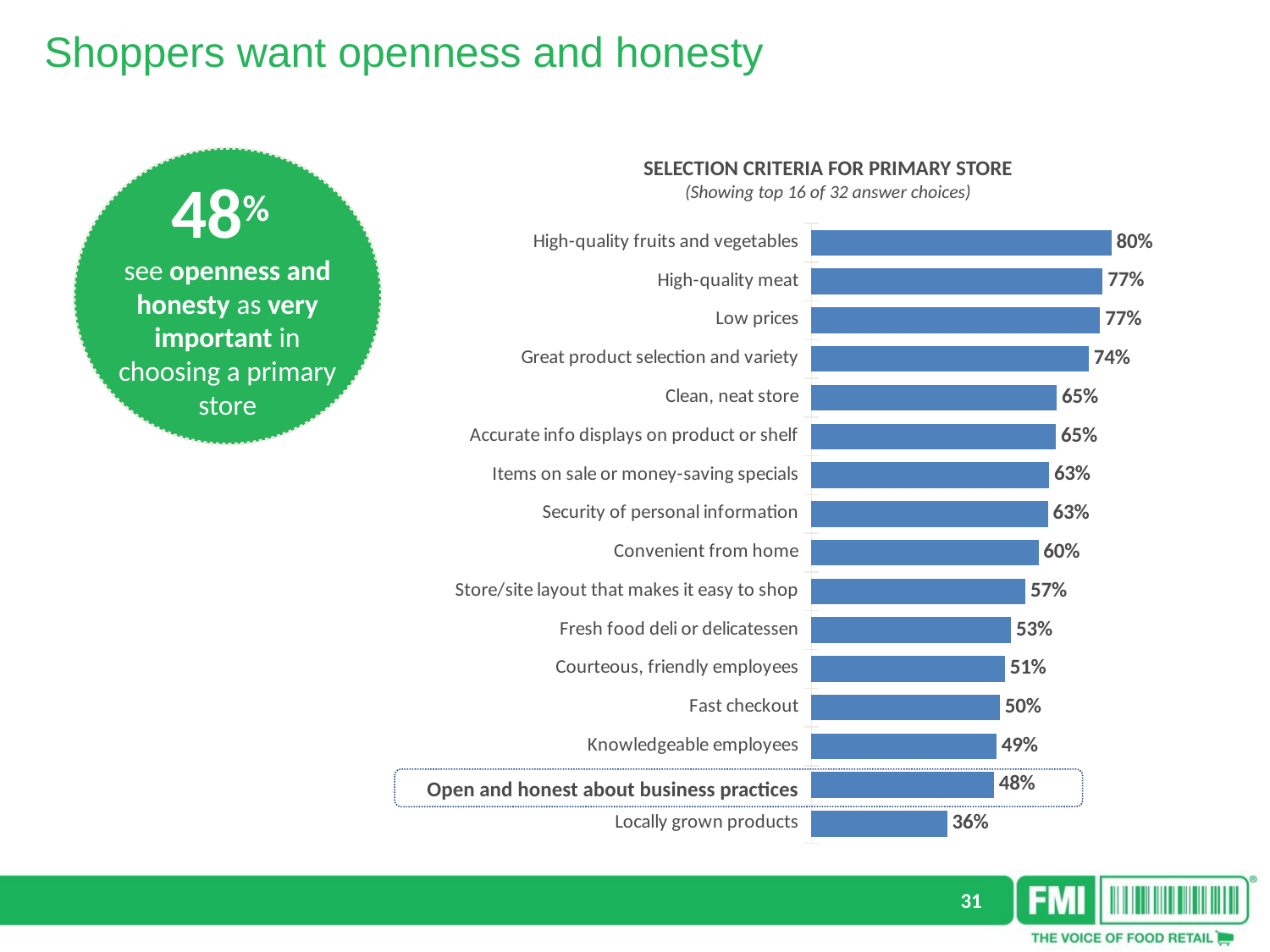
How many selection criteria are plotted in the chart? 16 What is the difference between the values for Fast checkout and Knowledgeable employees? 1% Which category label is highlighted with a dotted box in the chart? Open and honest about business practices Which selection criterion has the lowest value? Locally grown products What percentage is shown for Convenient from home? 60% Which selection criterion has the highest value? High-quality fruits and vegetables What is the value for Open and honest about business practices? 48% What is the difference between the values for High-quality fruits and vegetables and Locally grown products? 44% What is the title of the chart? SELECTION CRITERIA FOR PRIMARY STORE What percentage is shown for High-quality fruits and vegetables? 80% Which is larger, the value for Fresh food deli or delicatessen or the value for Courteous, friendly employees? Fresh food deli or delicatessen What kind of chart is shown on the slide? Bar chart